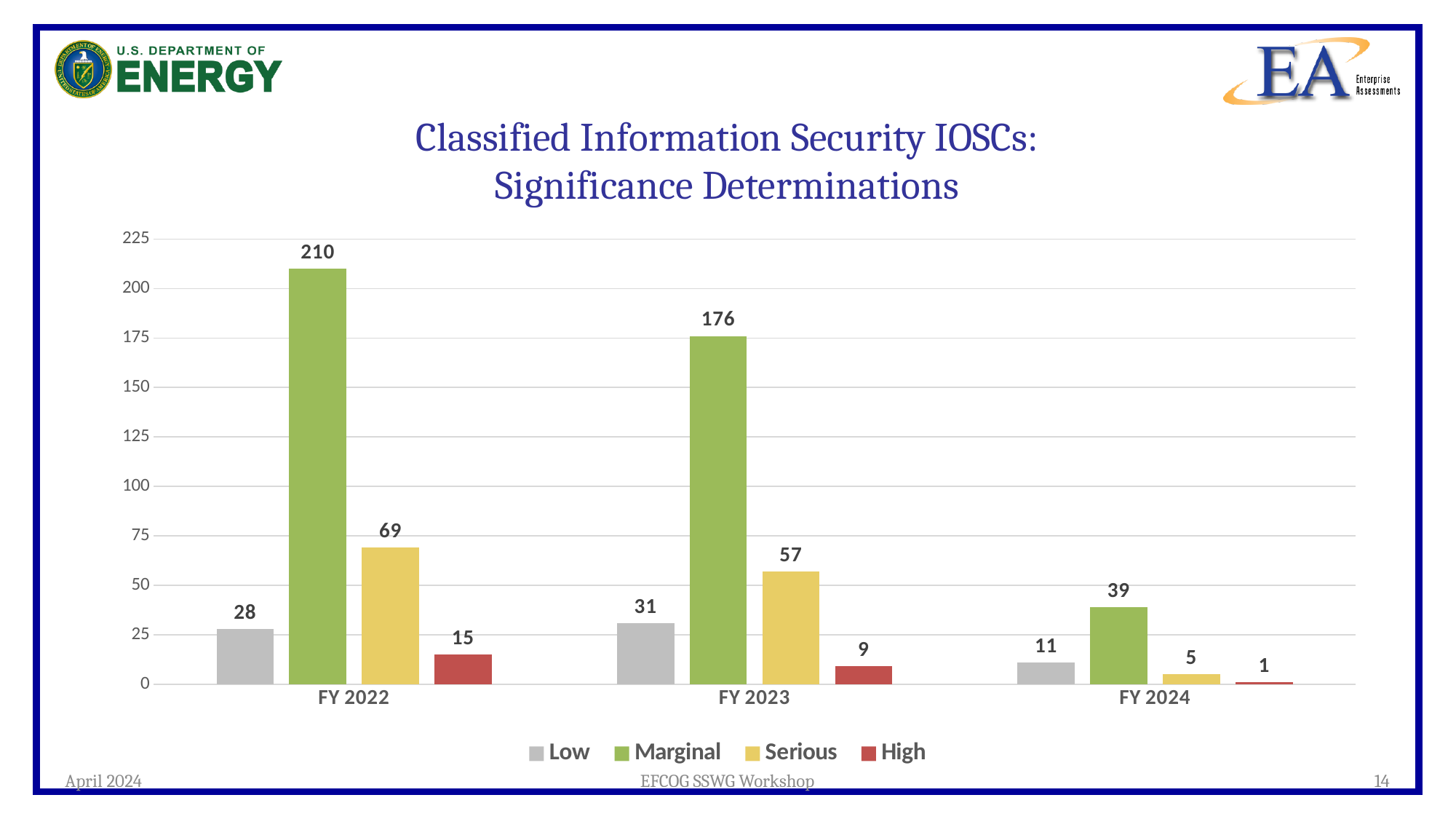
What is the value for Marginal in FY 2022? 210 Which fiscal year has the lowest Serious value? FY 2024 Which is larger, the Low value in FY 2022 or the Low value in FY 2023? FY 2023 What kind of chart is shown on the slide? Bar chart What is the value for Low in FY 2023? 31 How many series does the legend list? 4 What is the difference between the Marginal values for FY 2022 and FY 2023? 34 What is the value for High in FY 2024? 1 Do the Marginal values rise or fall from FY 2022 to FY 2024? Fall What is the value for Serious in FY 2023? 57 How many fiscal years are shown on the x axis? 3 Which fiscal year has the highest Marginal value? FY 2022